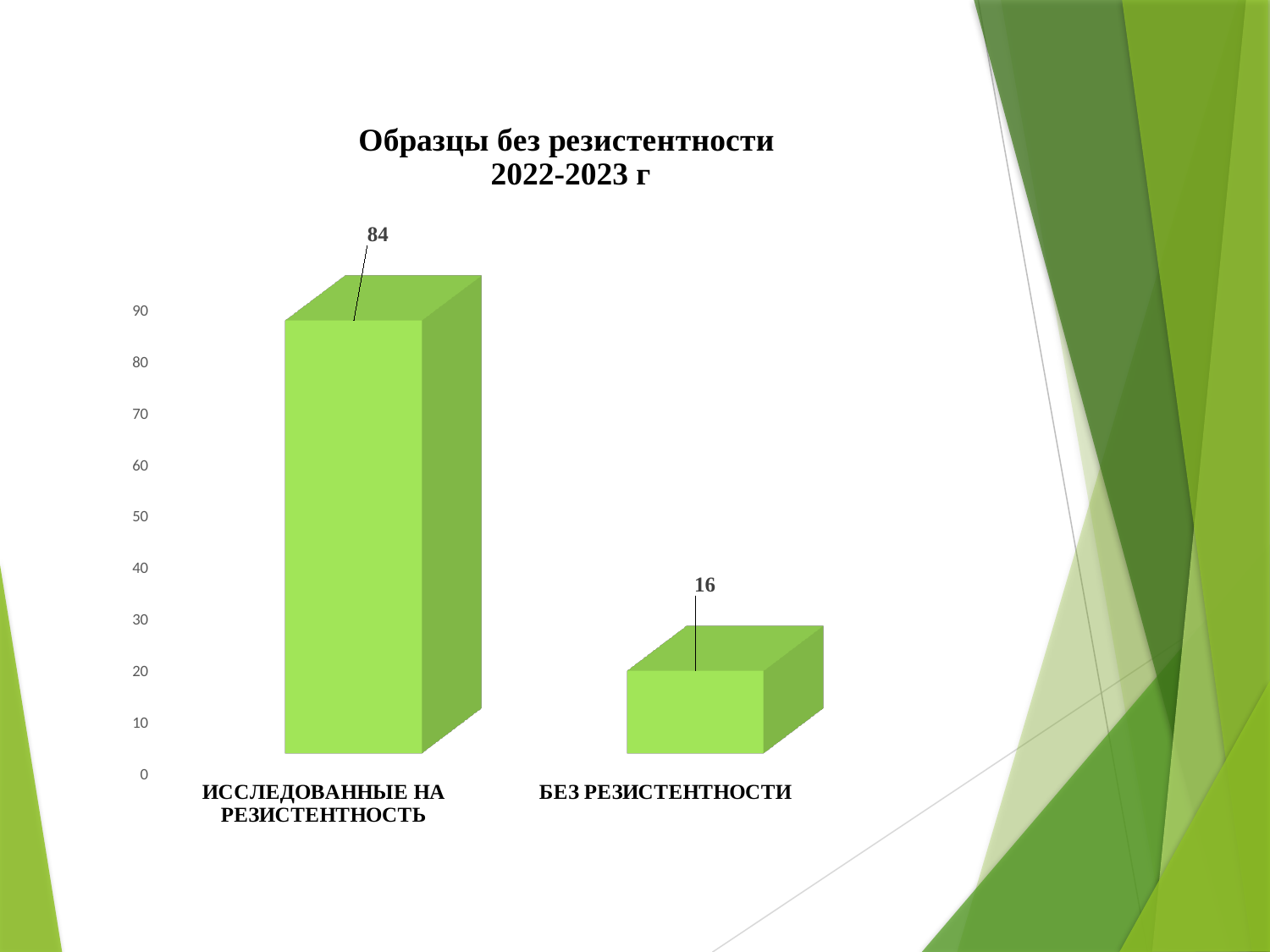
Is the value for ИССЛЕДОВАННЫЕ НА РЕЗИСТЕНТНОСТЬ greater or less than 60? greater What is the title of the chart? Образцы без резистентности 2022-2023 г What kind of chart is shown on the slide? bar chart What is the value for БЕЗ РЕЗИСТЕНТНОСТИ? 16 Is the value for БЕЗ РЕЗИСТЕНТНОСТИ greater or less than 50? less Which is larger, the value for ИССЛЕДОВАННЫЕ НА РЕЗИСТЕНТНОСТЬ or the value for БЕЗ РЕЗИСТЕНТНОСТИ? ИССЛЕДОВАННЫЕ НА РЕЗИСТЕНТНОСТЬ What is the difference between the values for ИССЛЕДОВАННЫЕ НА РЕЗИСТЕНТНОСТЬ and БЕЗ РЕЗИСТЕНТНОСТИ? 68 Which category has the lowest value? БЕЗ РЕЗИСТЕНТНОСТИ What is the highest value shown on the vertical axis? 90 Which category has the highest value? ИССЛЕДОВАННЫЕ НА РЕЗИСТЕНТНОСТЬ How many categories are shown in the chart? 2 What is the value for ИССЛЕДОВАННЫЕ НА РЕЗИСТЕНТНОСТЬ? 84